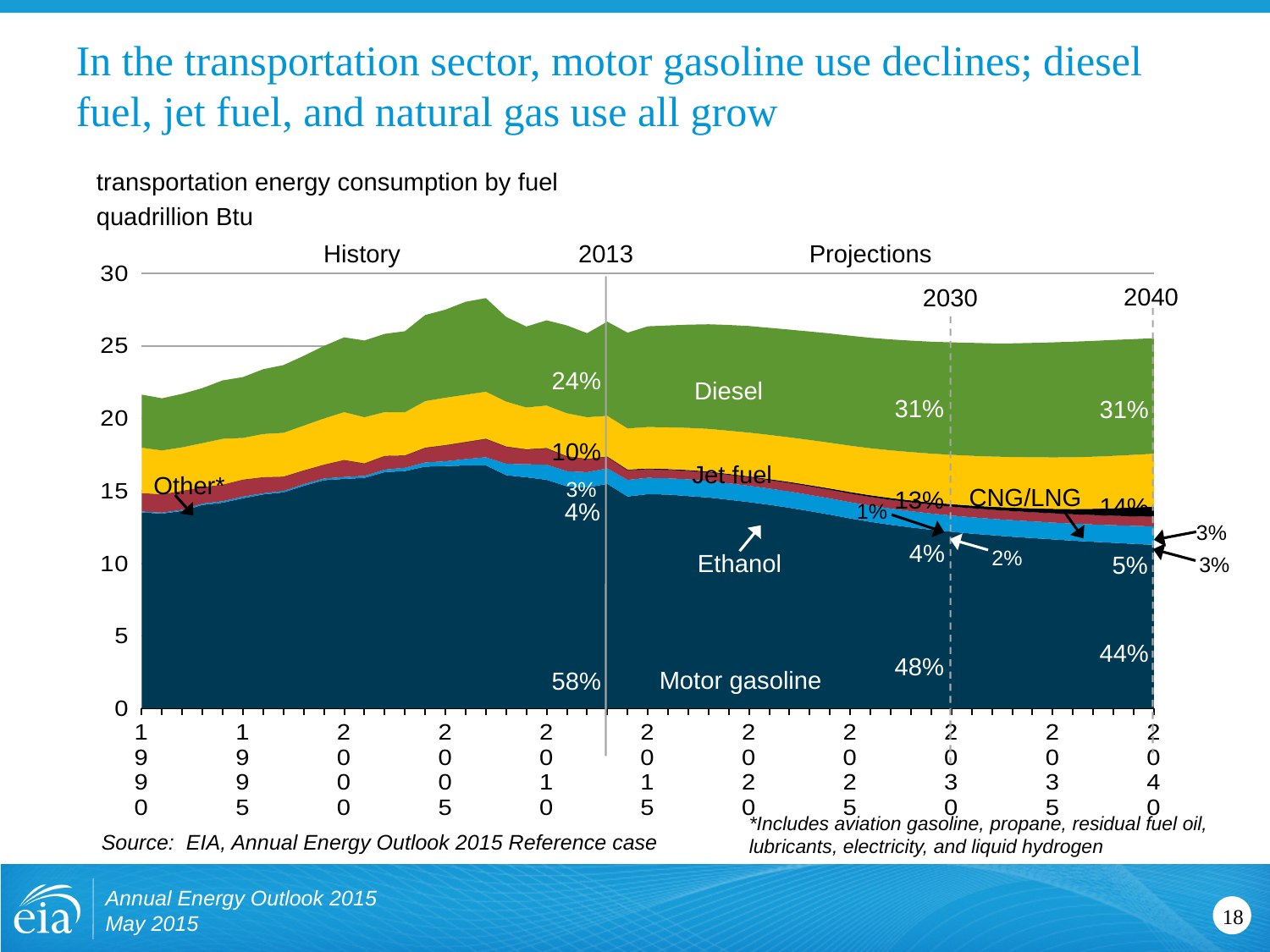
Which fuel has the largest share of transportation energy consumption in 2040? Motor gasoline What share does diesel account for in 2030? 31% What share of transportation energy consumption does motor gasoline account for in 2013? 58% Is total transportation energy consumption in 1990 greater or less than 25 quadrillion Btu? less What kind of chart is shown on the slide? stacked area chart In what unit is transportation energy consumption measured on the chart? quadrillion Btu What share of transportation energy consumption does motor gasoline account for in 2040? 44% Does the share of motor gasoline rise or fall from 2013 to 2040? fall By how many percentage points does the motor gasoline share fall between 2013 and 2040? 14 percentage points Is motor gasoline consumption in 2040 greater or less than 15 quadrillion Btu? less What share does jet fuel account for in 2040? 14% What share does CNG/LNG account for in 2030? 1%